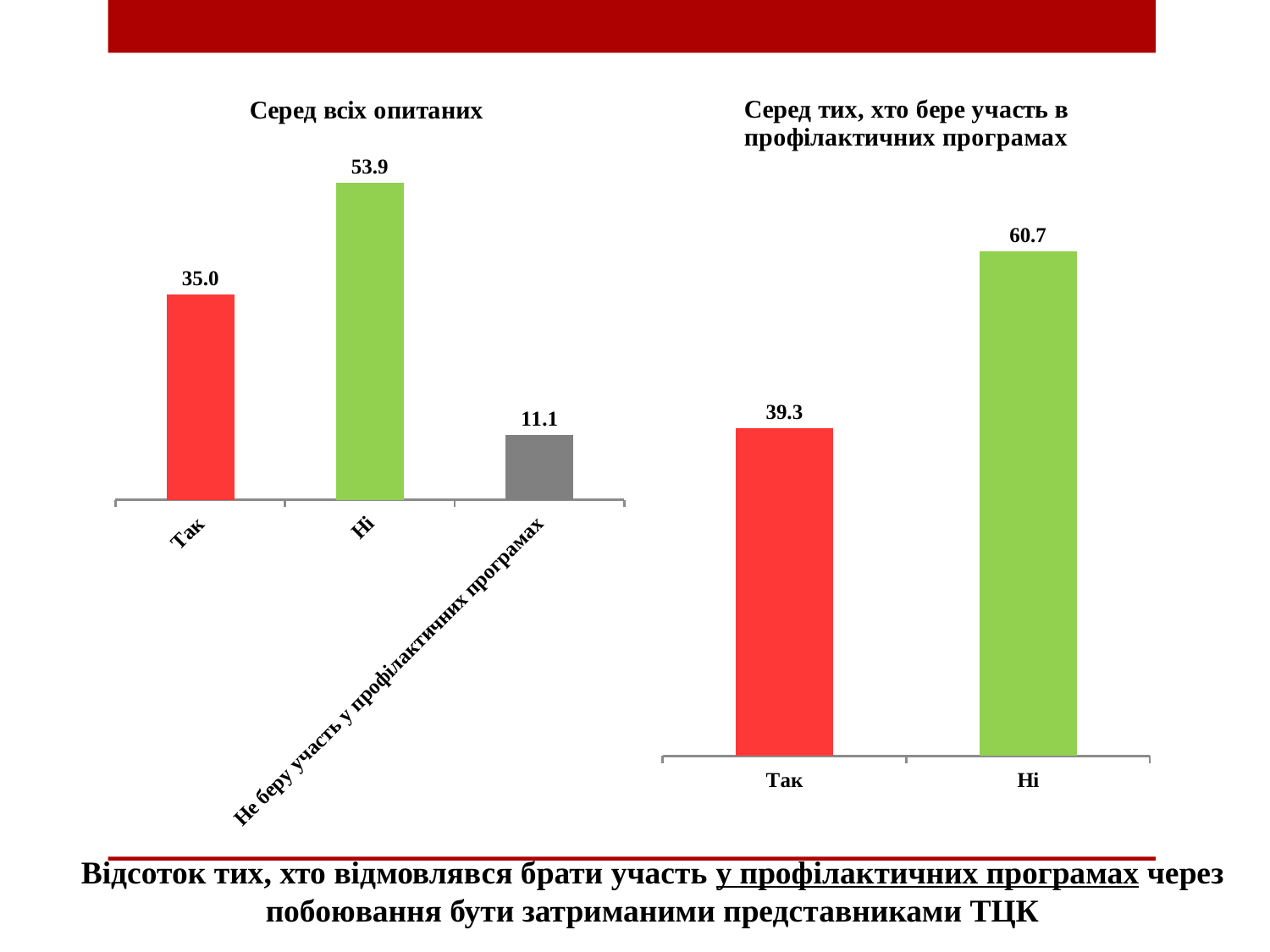
In the chart titled 'Серед тих, хто бере участь в профілактичних програмах', which is larger, 'Так' or 'Ні'? Ні In the chart titled 'Серед всіх опитаних', what is the difference between the values for 'Ні' and 'Так'? 18.9 In the chart titled 'Серед всіх опитаних', which category has the lowest value? Не беру участь у профілактичних програмах How many categories are shown in the chart titled 'Серед всіх опитаних'? 3 In the chart titled 'Серед всіх опитаних', what is the value for 'Не беру участь у профілактичних програмах'? 11.1 In the chart titled 'Серед всіх опитаних', what is the value for 'Ні'? 53.9 In the chart titled 'Серед тих, хто бере участь в профілактичних програмах', what is the value for 'Так'? 39.3 In the chart titled 'Серед тих, хто бере участь в профілактичних програмах', what is the value for 'Ні'? 60.7 In the chart titled 'Серед всіх опитаних', what is the value for 'Так'? 35.0 In the chart titled 'Серед всіх опитаних', which category has the highest value? Ні What type of chart is the chart titled 'Серед тих, хто бере участь в профілактичних програмах'? Bar chart In the chart titled 'Серед тих, хто бере участь в профілактичних програмах', what is the difference between the values for 'Ні' and 'Так'? 21.4